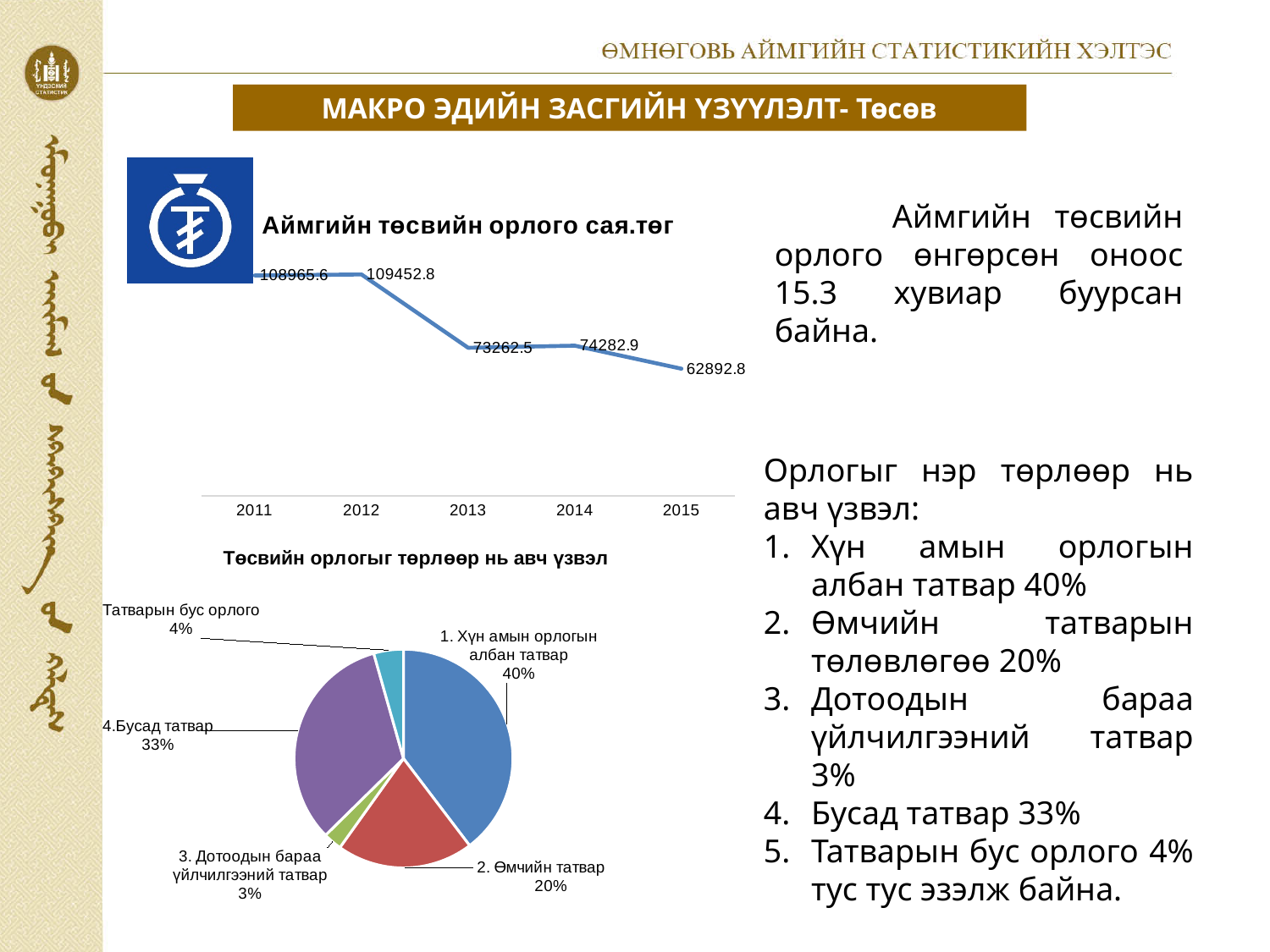
What kind of chart is the chart titled 'Аймгийн төсвийн орлого сая.төг'? Line chart In the chart titled 'Аймгийн төсвийн орлого сая.төг', do the values overall rise or fall from 2011 to 2015? Fall In the chart titled 'Аймгийн төсвийн орлого сая.төг', which year has the lowest value? 2015 In the chart titled 'Аймгийн төсвийн орлого сая.төг', what is the value for 2015? 62892.8 In the chart titled 'Аймгийн төсвийн орлого сая.төг', how many years are plotted on the x axis? 5 In the chart titled 'Аймгийн төсвийн орлого сая.төг', which year has the highest value? 2012 In the pie chart titled 'Төсвийн орлогыг төрлөөр нь авч үзвэл', how many slices are there? 5 In the pie chart titled 'Төсвийн орлогыг төрлөөр нь авч үзвэл', what share does '2. Өмчийн татвар' have? 20% In the pie chart titled 'Төсвийн орлогыг төрлөөр нь авч үзвэл', which category has the largest share? 1. Хүн амын орлогын албан татвар In the chart titled 'Аймгийн төсвийн орлого сая.төг', what is the difference between the values for 2014 and 2015? 11390.1 In the pie chart titled 'Төсвийн орлогыг төрлөөр нь авч үзвэл', which category has the smallest share? 3. Дотоодын бараа үйлчилгээний татвар In the chart titled 'Аймгийн төсвийн орлого сая.төг', what is the value for 2013? 73262.5